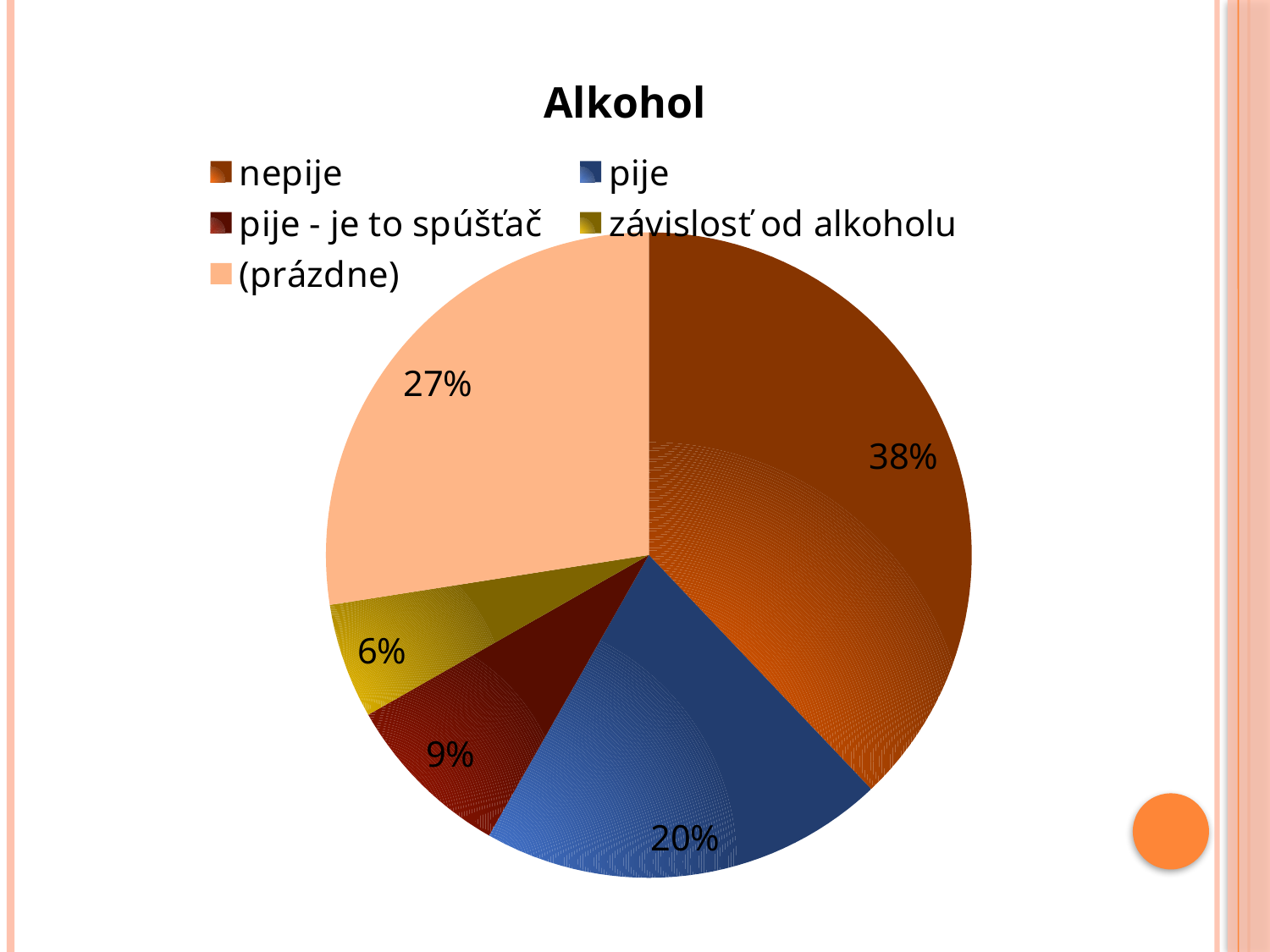
What share of the pie does the 'pije - je to spúšťač' slice represent? 9% Which category has the smallest slice of the pie? závislosť od alkoholu What share of the pie does the 'závislosť od alkoholu' slice represent? 6% What share of the pie does the 'nepije' slice represent? 38% Which slice is larger, 'pije' or 'pije - je to spúšťač'? pije What kind of chart is shown on the slide? pie chart What is the title of the chart? Alkohol What is the difference in percentage points between the 'nepije' slice and the '(prázdne)' slice? 11% Which category has the largest slice of the pie? nepije How many categories does the pie chart show? 5